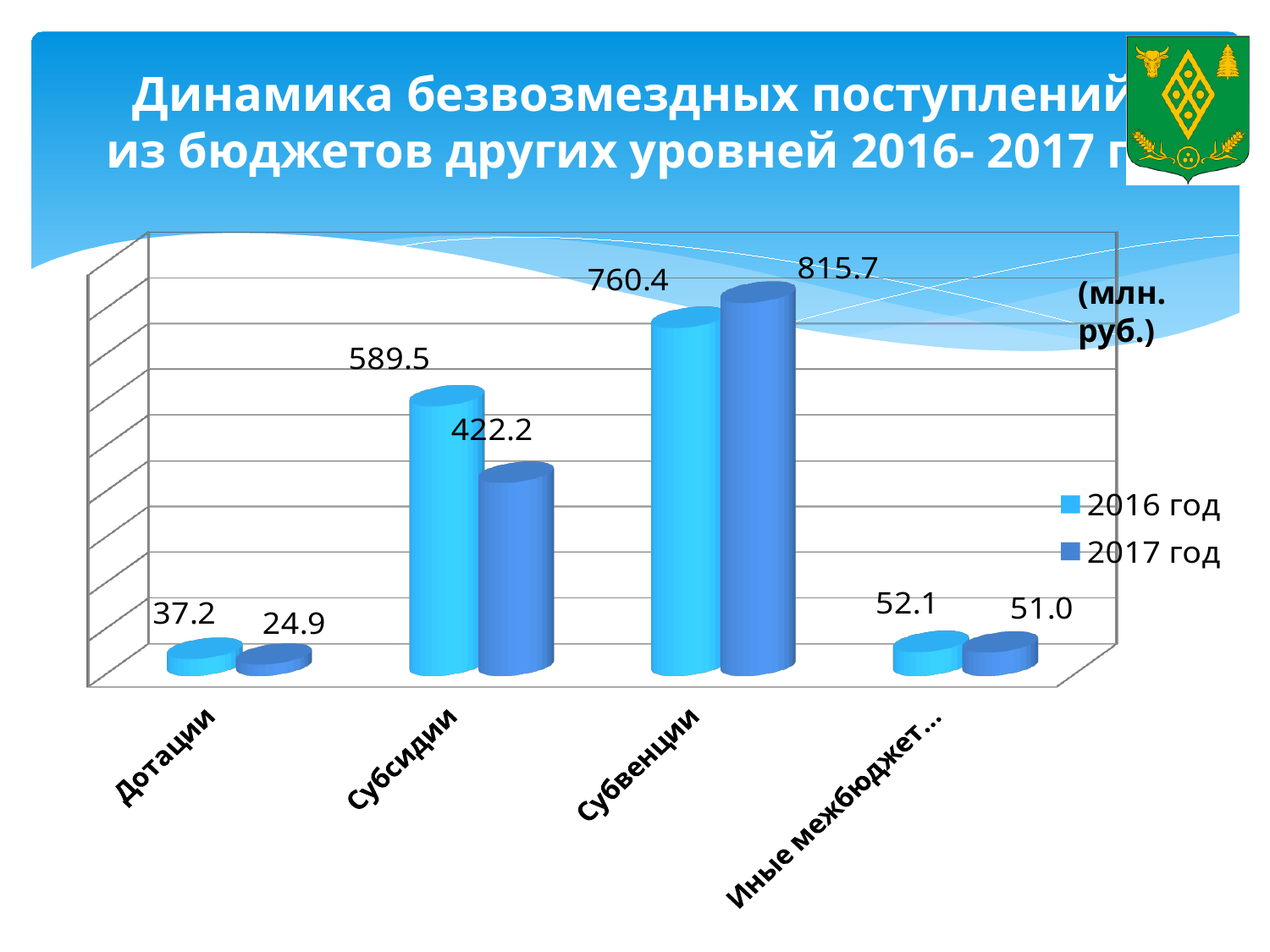
What is the difference between the 2017 год and 2016 год values for Субвенции? 55.3 What is the value for Дотации in 2016 год? 37.2 What kind of chart is shown on the slide? Bar chart What is the difference between the 2016 год and 2017 год values for Субсидии? 167.3 What is the value for Субсидии in 2017 год? 422.2 Which is larger for Дотации: the 2016 год value or the 2017 год value? 2016 год What is the value for Субвенции in 2017 год? 815.7 How many categories are shown on the x axis? 4 Which category has the lowest value in 2017 год? Дотации How many series does the legend list? 2 Which category has the highest value in 2016 год? Субвенции What is the value for Субвенции in 2016 год? 760.4